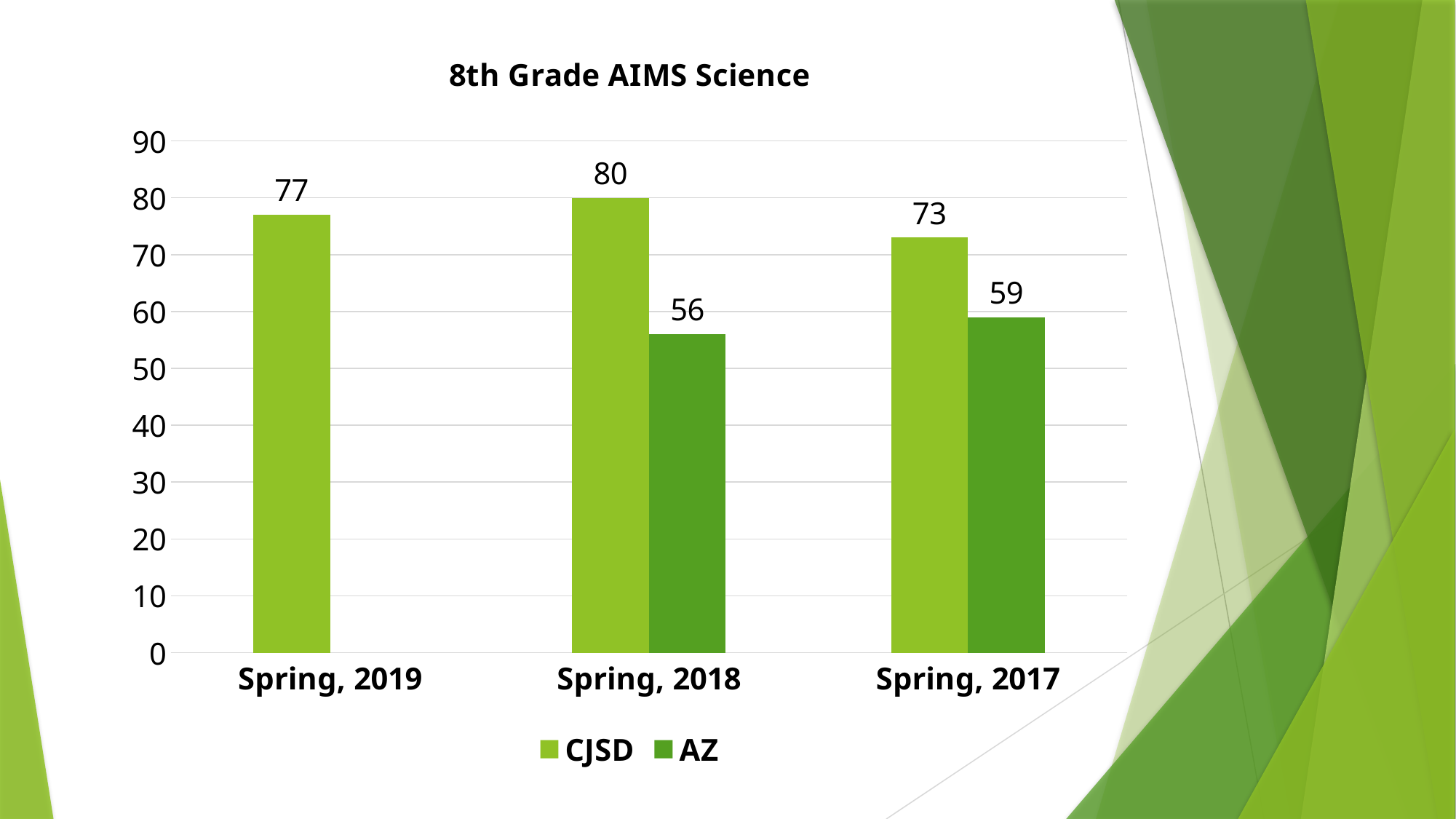
What is the difference between the CJSD and AZ values for Spring, 2018? 24 Which category has the highest CJSD value? Spring, 2018 What is the AZ value for Spring, 2017? 59 What is the CJSD value for Spring, 2017? 73 What kind of chart is shown on the slide? Bar chart Which category has the lowest CJSD value? Spring, 2017 What is the title of the chart? 8th Grade AIMS Science What is the CJSD value for Spring, 2019? 77 How many series does the legend list? 2 How many categories are shown on the x axis? 3 What is the AZ value for Spring, 2018? 56 Which is larger for Spring, 2017: the CJSD value or the AZ value? CJSD